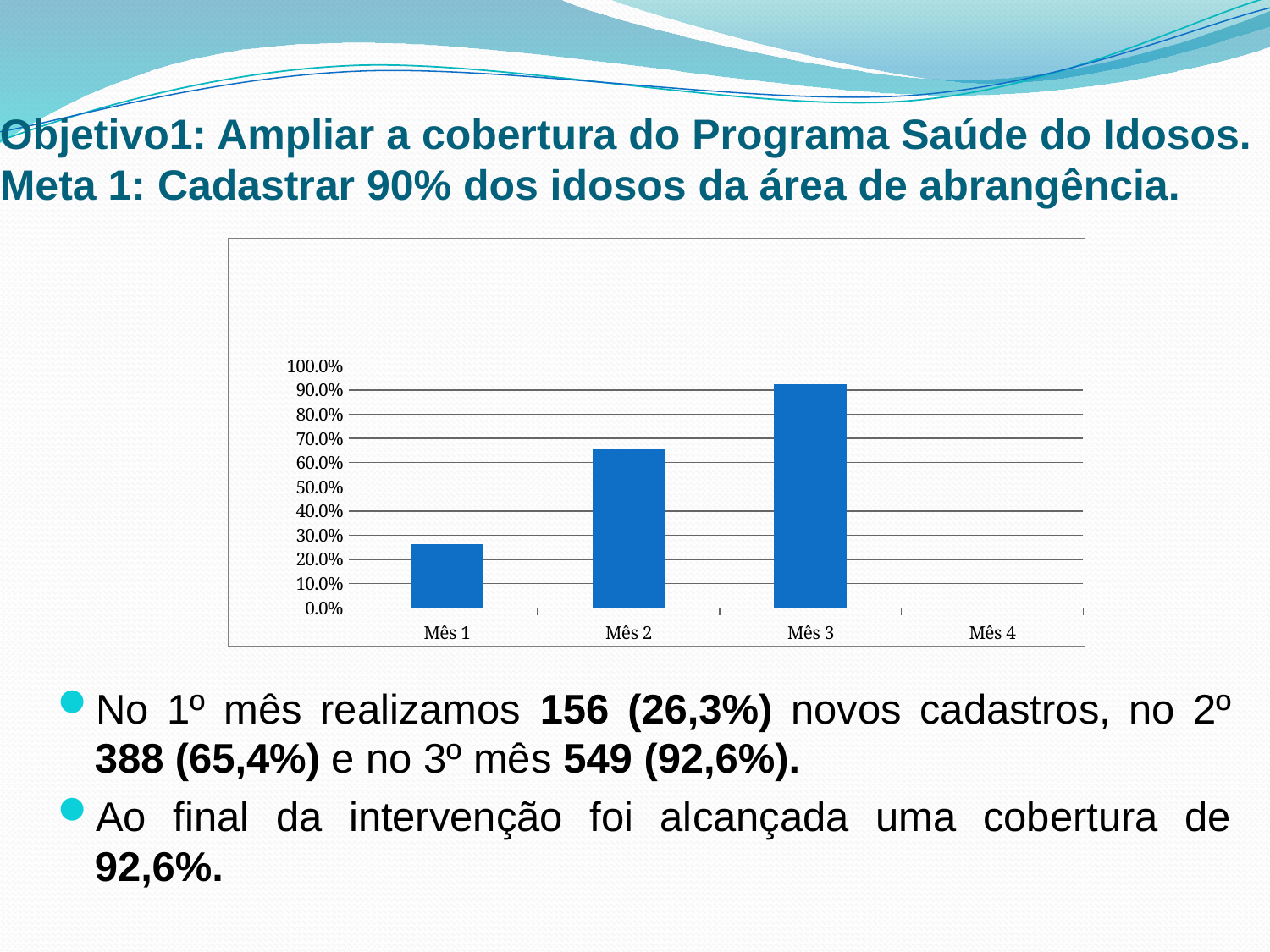
Is the value for Mês 1 greater or less than 20.0%? greater What colour are the bars in the chart? blue Is the value for Mês 2 greater or less than 60.0%? greater What is the highest tick value shown on the y axis of the chart? 100.0% Which is larger, the value for Mês 1 or the value for Mês 2? Mês 2 Is the value for Mês 3 greater or less than 90.0%? greater Do the bar values rise or fall from Mês 1 to Mês 3? rise How many categories are shown on the x axis of the chart? 4 What kind of chart is shown on the slide? bar chart Which month has the highest bar in the chart? Mês 3